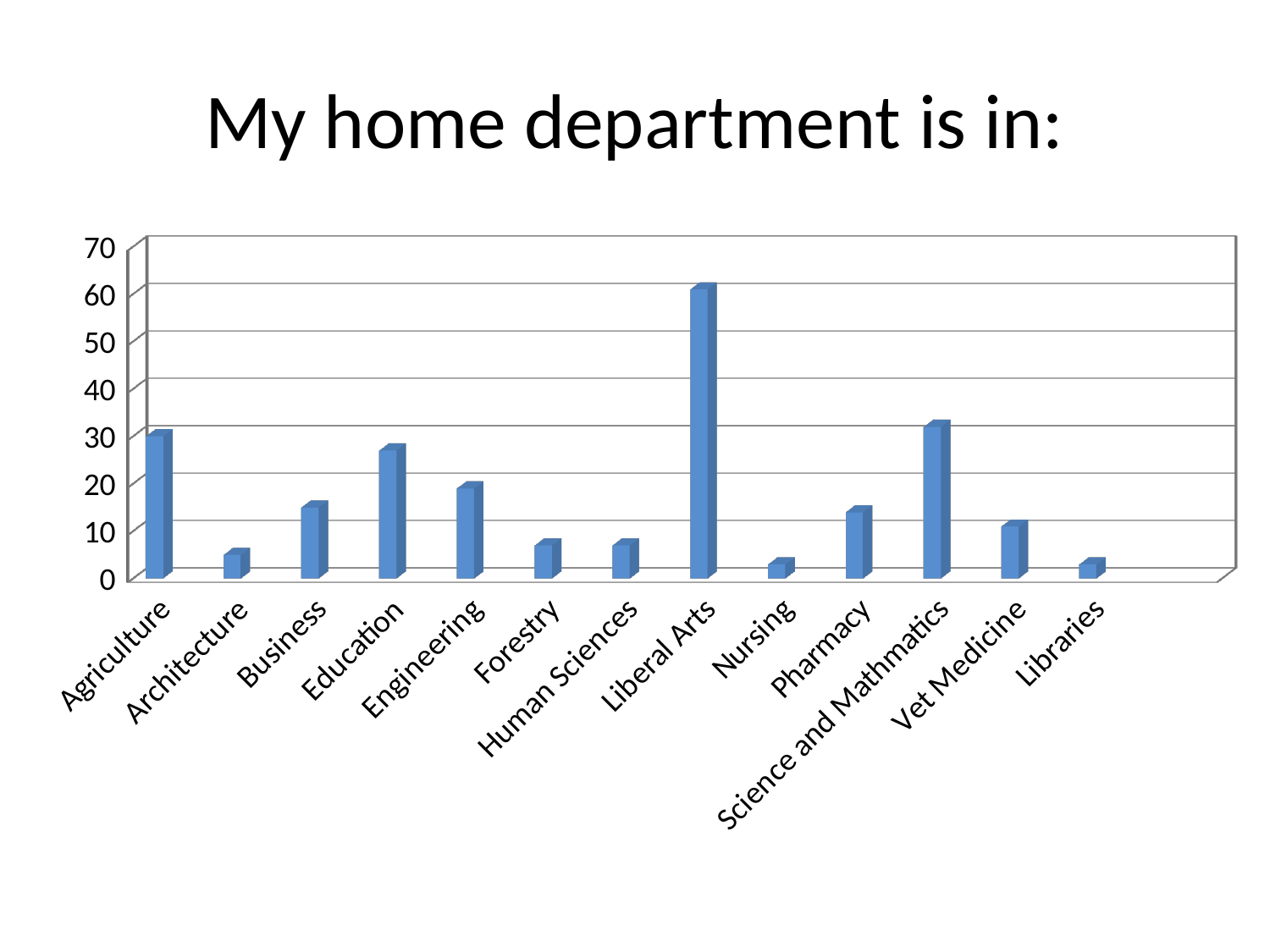
Is the value for Liberal Arts greater or less than 50? greater Which category has the highest value? Liberal Arts What kind of chart is shown on the slide? bar chart How many categories are shown on the x axis? 13 Is the value for Architecture greater or less than 10? less Is the value for Nursing greater or less than 10? less Which is larger, the value for Engineering or the value for Forestry? Engineering What is the title of the chart? My home department is in: Which is larger, the value for Education or the value for Business? Education Which is larger, the value for Science and Mathmatics or the value for Pharmacy? Science and Mathmatics